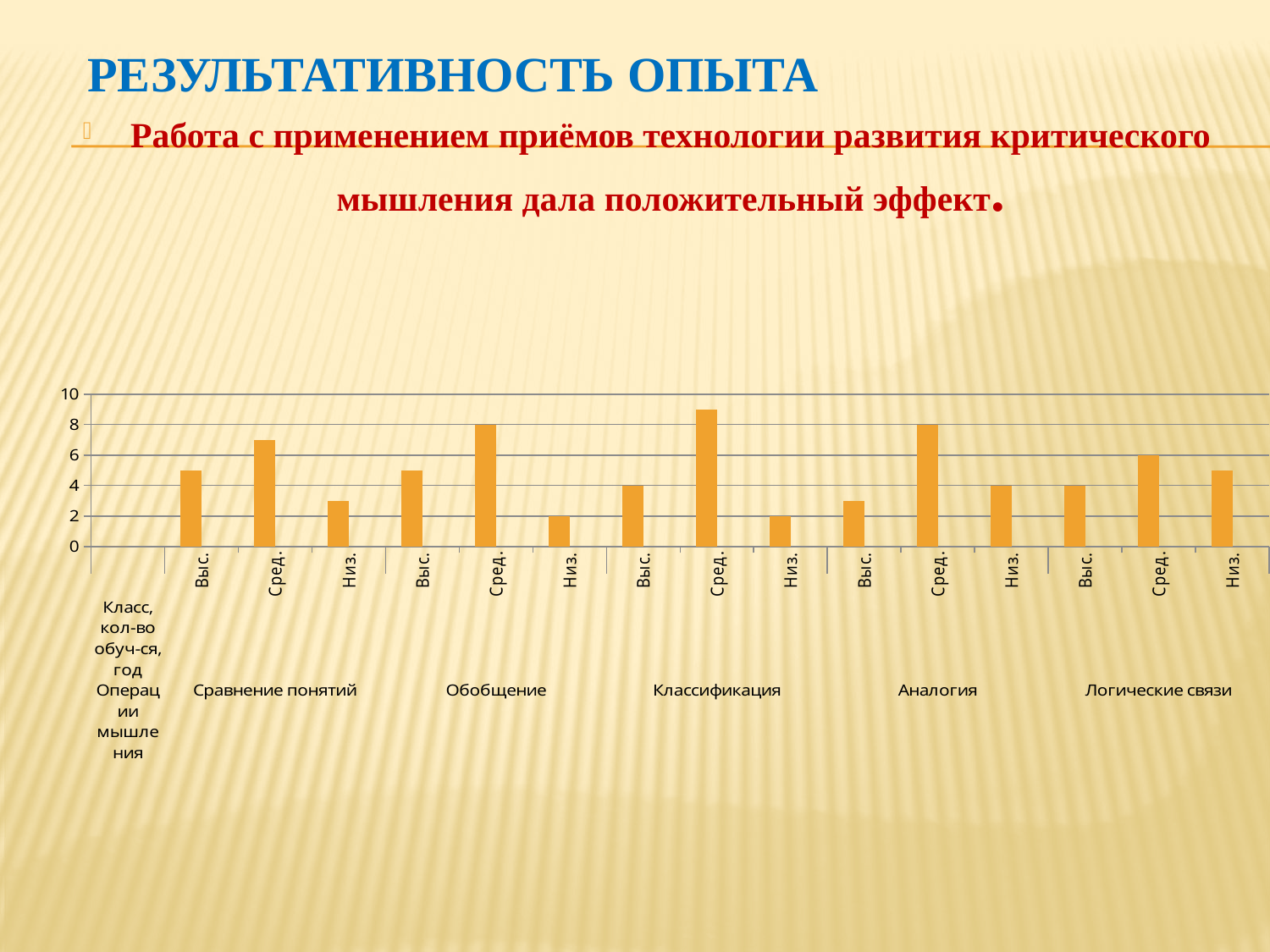
What kind of chart is shown on the slide? bar chart Is the value of the Выс. bar in the Аналогия group greater or less than 4? less Is the value of the Сред. bar in the Сравнение понятий group greater or less than 6? greater In the Сравнение понятий group, which is larger: the Выс. bar or the Низ. bar? Выс. What is the value of the Низ. bar in the Аналогия group? 4 What is the value of the Сред. bar in the Обобщение group? 8 How many groups of thinking operations are shown along the x axis of the chart? 5 How many bars are plotted in the chart in total? 15 Which bar in the chart is the highest overall? Сред. in Классификация What is the value of the Низ. bar in the Обобщение group? 2 What is the value of the Сред. bar in the Логические связи group? 6 What is the difference between the Сред. and Низ. bars in the Обобщение group? 6